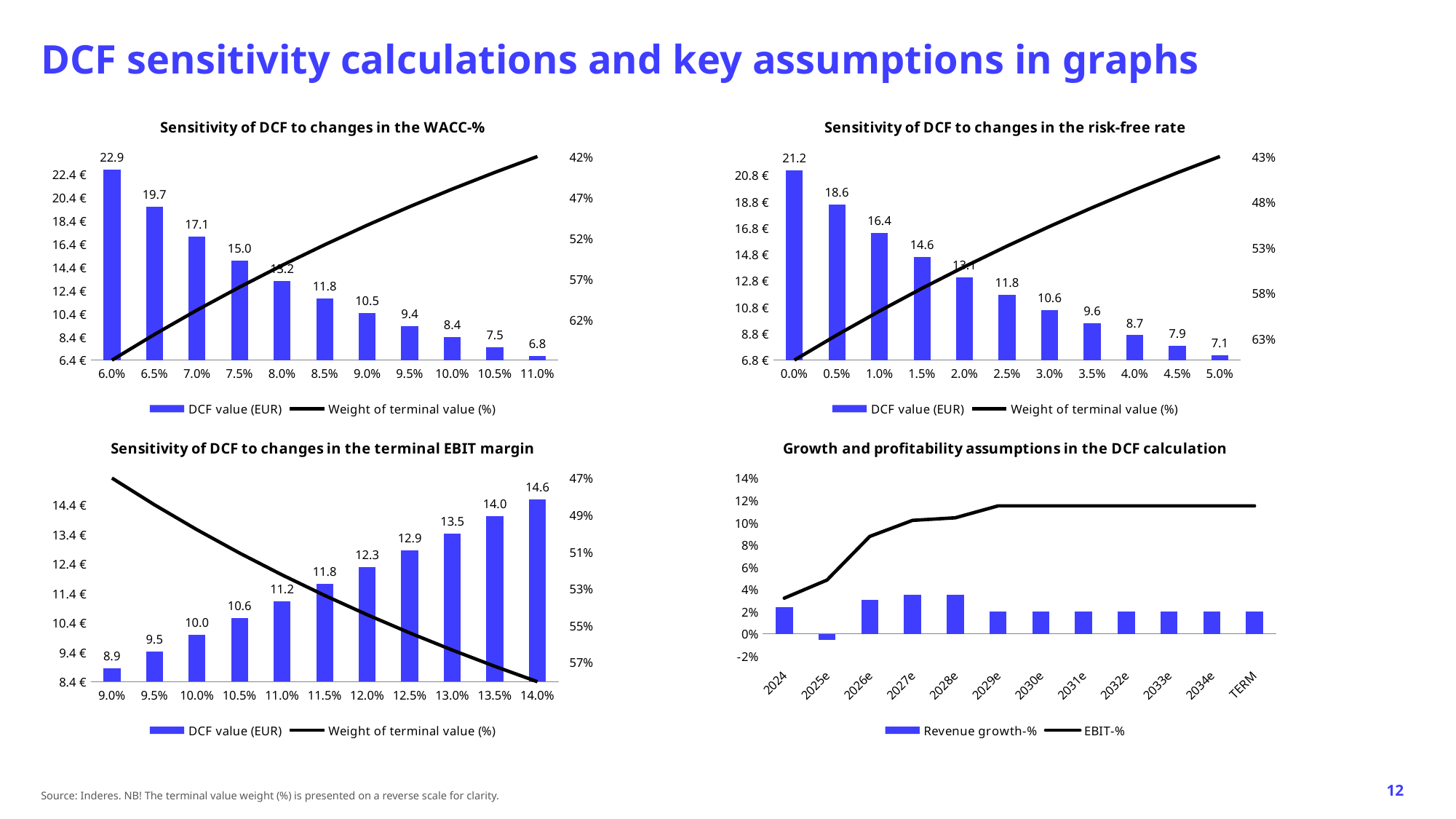
In the 'Sensitivity of DCF to changes in the terminal EBIT margin' chart, do the DCF values rise or fall as the terminal EBIT margin increases? rise How many series does the legend list in the 'Growth and profitability assumptions in the DCF calculation' chart? 2 In the 'Sensitivity of DCF to changes in the WACC-%' chart, what is the DCF value at a WACC of 7.5%? 15.0 In the 'Growth and profitability assumptions in the DCF calculation' chart, is the EBIT-% for TERM greater or less than 10%? greater In the 'Sensitivity of DCF to changes in the WACC-%' chart, what is the difference between the DCF values at 6.0% and 11.0%? 16.1 In the 'Sensitivity of DCF to changes in the terminal EBIT margin' chart, what is the DCF value at a terminal EBIT margin of 12.5%? 12.9 In the 'Sensitivity of DCF to changes in the risk-free rate' chart, what is the DCF value at a risk-free rate of 3.0%? 10.6 In the 'Sensitivity of DCF to changes in the terminal EBIT margin' chart, which is larger: the DCF value at 10.5% or at 11.5%? 11.5% In the 'Sensitivity of DCF to changes in the risk-free rate' chart, how many risk-free rate categories are shown on the x axis? 11 In the 'Sensitivity of DCF to changes in the risk-free rate' chart, which risk-free rate gives the lowest DCF value? 5.0% In the 'Sensitivity of DCF to changes in the WACC-%' chart, which WACC level gives the highest DCF value? 6.0% In the 'Growth and profitability assumptions in the DCF calculation' chart, is the revenue growth-% for 2025e greater or less than 0%? less